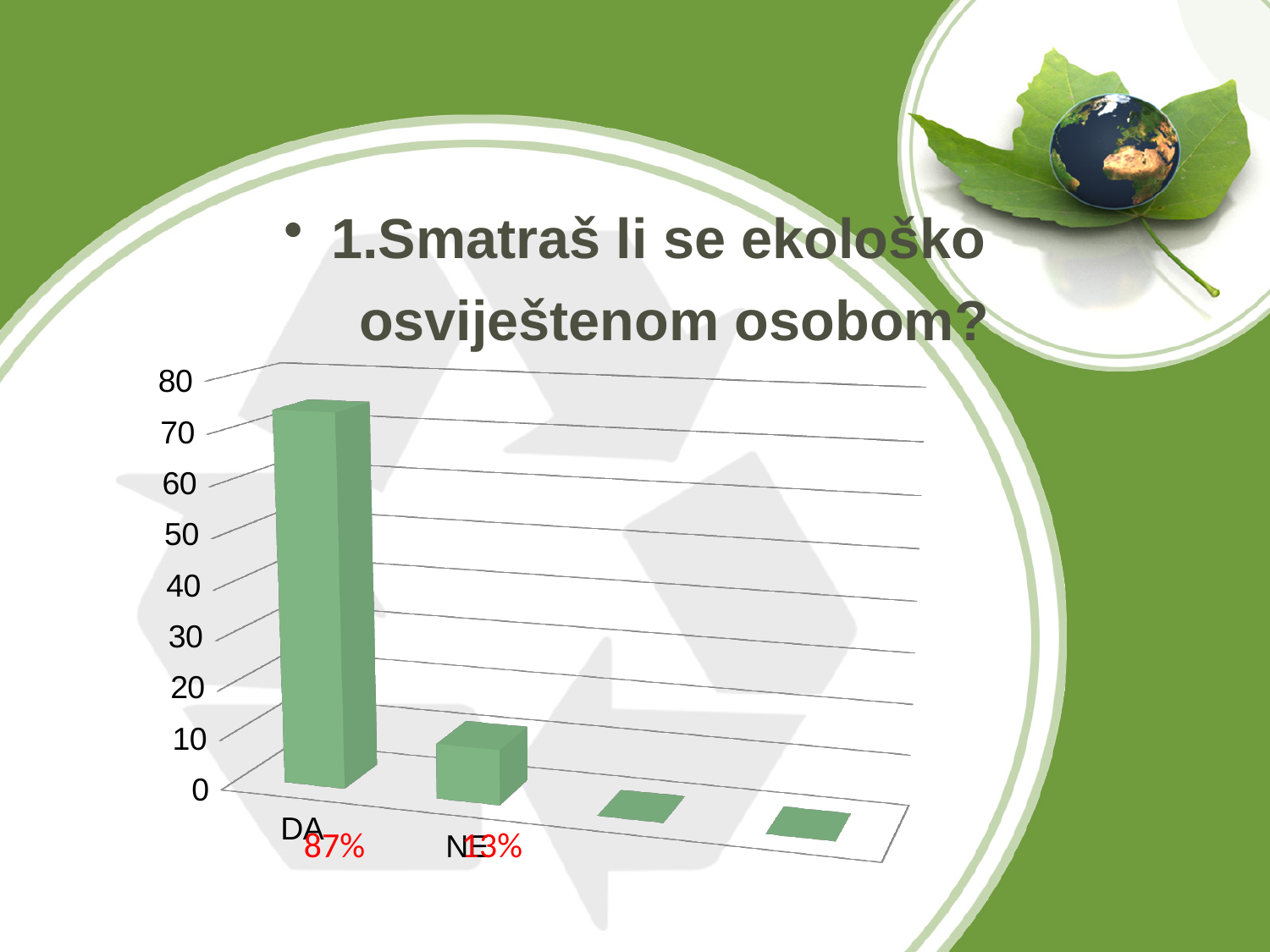
What is the highest value shown on the vertical axis? 80 Is the value for DA greater or less than 80? less Is the value for DA greater or less than 60? greater What question is the chart answering, according to the slide title? 1.Smatraš li se ekološko osviještenom osobom? Which labeled category has the shortest bar, DA or NE? NE What percentage is printed in red under the DA bar? 87% What kind of chart is shown on the slide? bar chart What percentage is printed in red near the NE bar? 13% Is the value for NE greater or less than 20? less Which labeled category has the tallest bar, DA or NE? DA Is the bar for DA taller or shorter than the bar for NE? taller